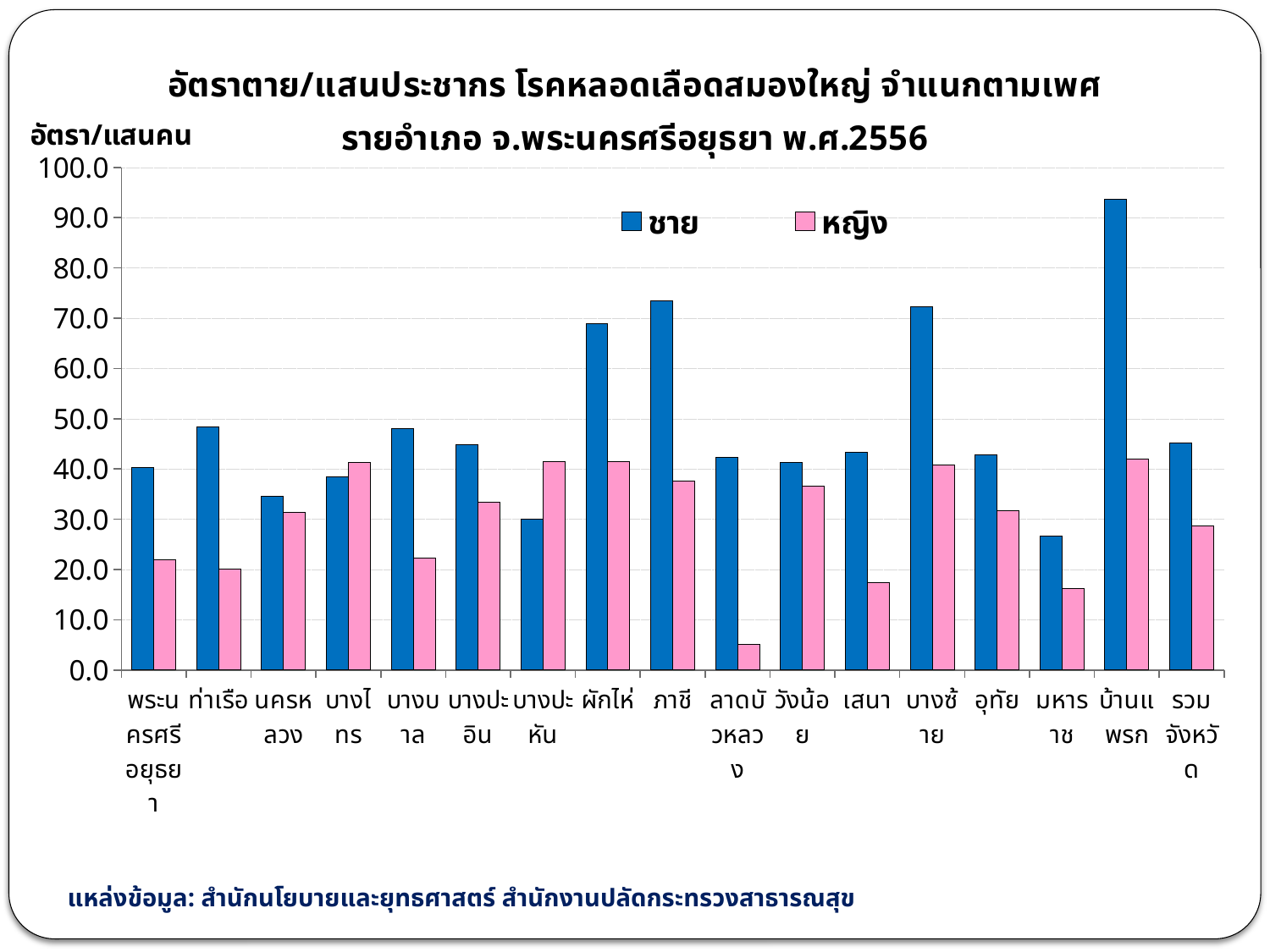
Is the value for หญิง in ลาดบัวหลวง greater or less than 10? less Is the value for ชาย in บ้านแพรก greater or less than 90? greater Is the value for หญิง in เสนา greater or less than 20? less Which category has the lowest value for หญิง? ลาดบัวหลวง Which category has the highest value for ชาย? บ้านแพรก Which category has the lowest value for ชาย? มหาราช Which colour represents the หญิง series in the legend? pink How many series does the legend list? 2 How many categories are shown on the x axis? 17 In บางปะหัน, which series has the larger value, ชาย or หญิง? หญิง What kind of chart is shown on the slide? bar chart